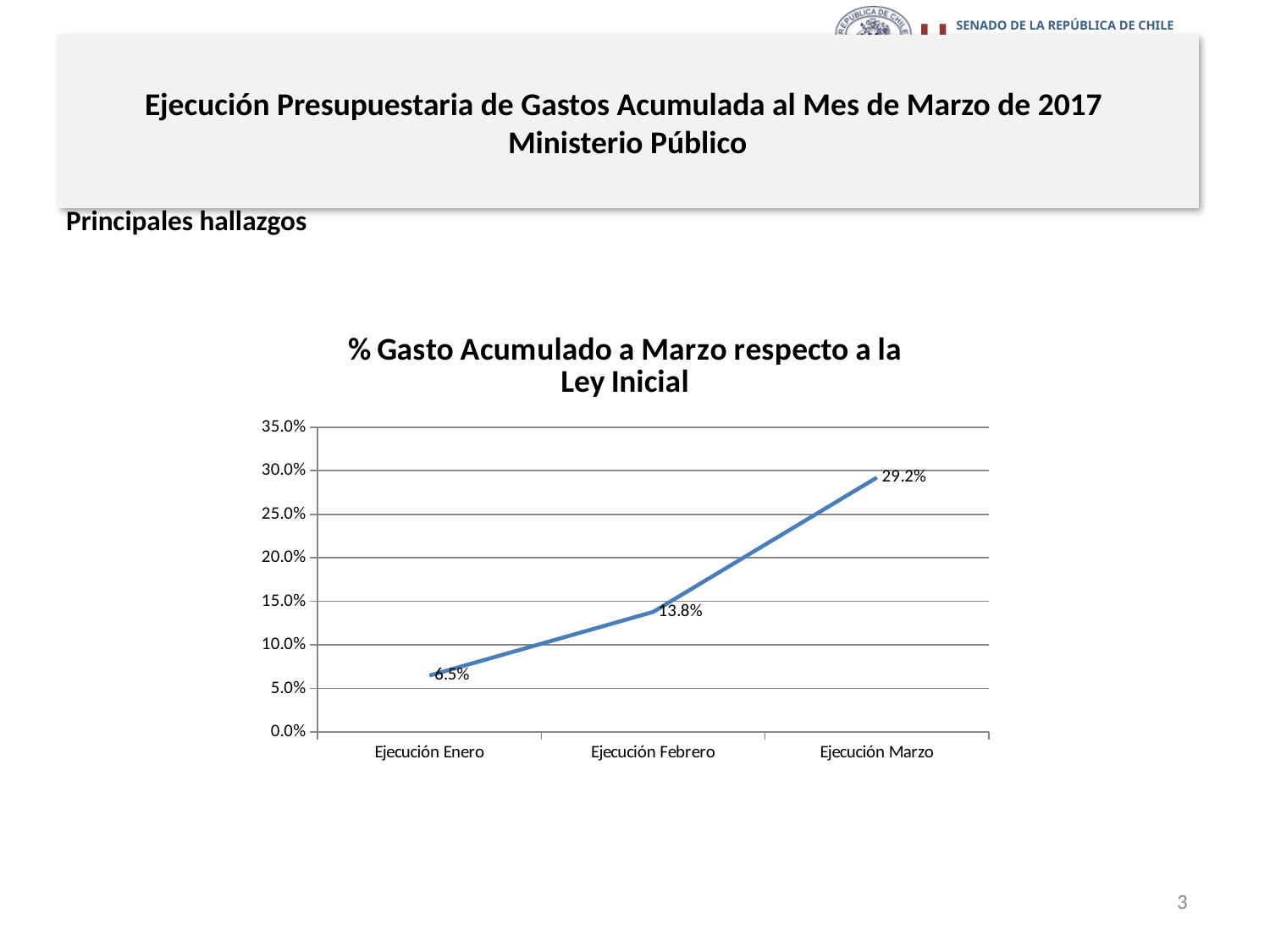
Which category has the highest value? Ejecución Marzo Is the value for Ejecución Marzo greater or less than 25.0%? greater Do the values rise or fall from Ejecución Enero to Ejecución Marzo? rise Which is larger, the value for Ejecución Febrero or Ejecución Enero? Ejecución Febrero What is the difference between the values for Ejecución Marzo and Ejecución Febrero? 15.4% What is the value for Ejecución Enero? 6.5% Which category has the lowest value? Ejecución Enero What is the value for Ejecución Marzo? 29.2% What kind of chart is shown on the slide? line chart What is the value for Ejecución Febrero? 13.8% What is the difference between the values for Ejecución Febrero and Ejecución Enero? 7.3% How many categories are plotted on the x axis? 3